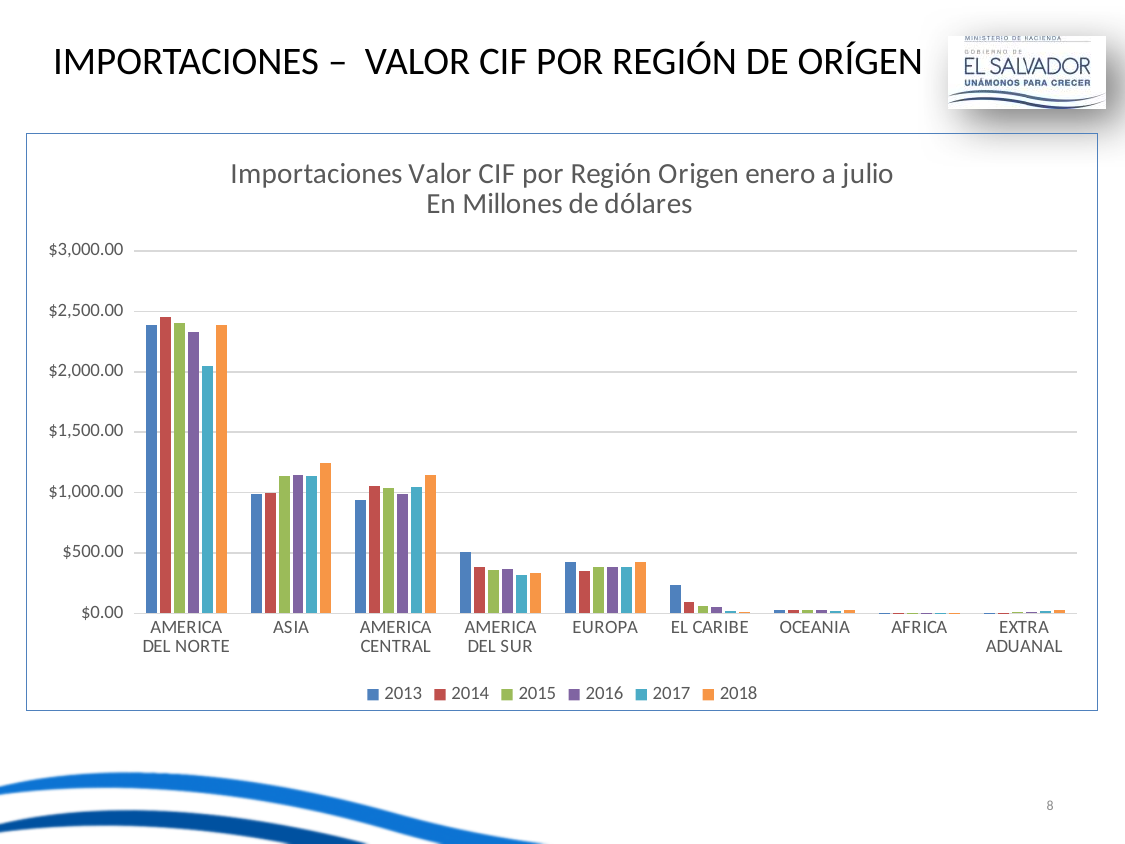
Do the values for EL CARIBE rise or fall from 2013 to 2018? fall Is the 2017 value for AMERICA DEL NORTE greater or less than $2,500.00? less Is the 2013 value for EUROPA greater or less than $500.00? less Is the 2014 value for AMERICA DEL SUR greater or less than $500.00? less What kind of chart is shown on the slide? bar chart Which region has the highest import values across all years? AMERICA DEL NORTE How many regions are shown on the x axis? 9 What colour represents the 2018 series in the legend? orange How many series does the legend list? 6 Within AMERICA DEL NORTE, which year has the lowest value? 2017 For EL CARIBE, which is larger: the 2013 value or the 2018 value? 2013